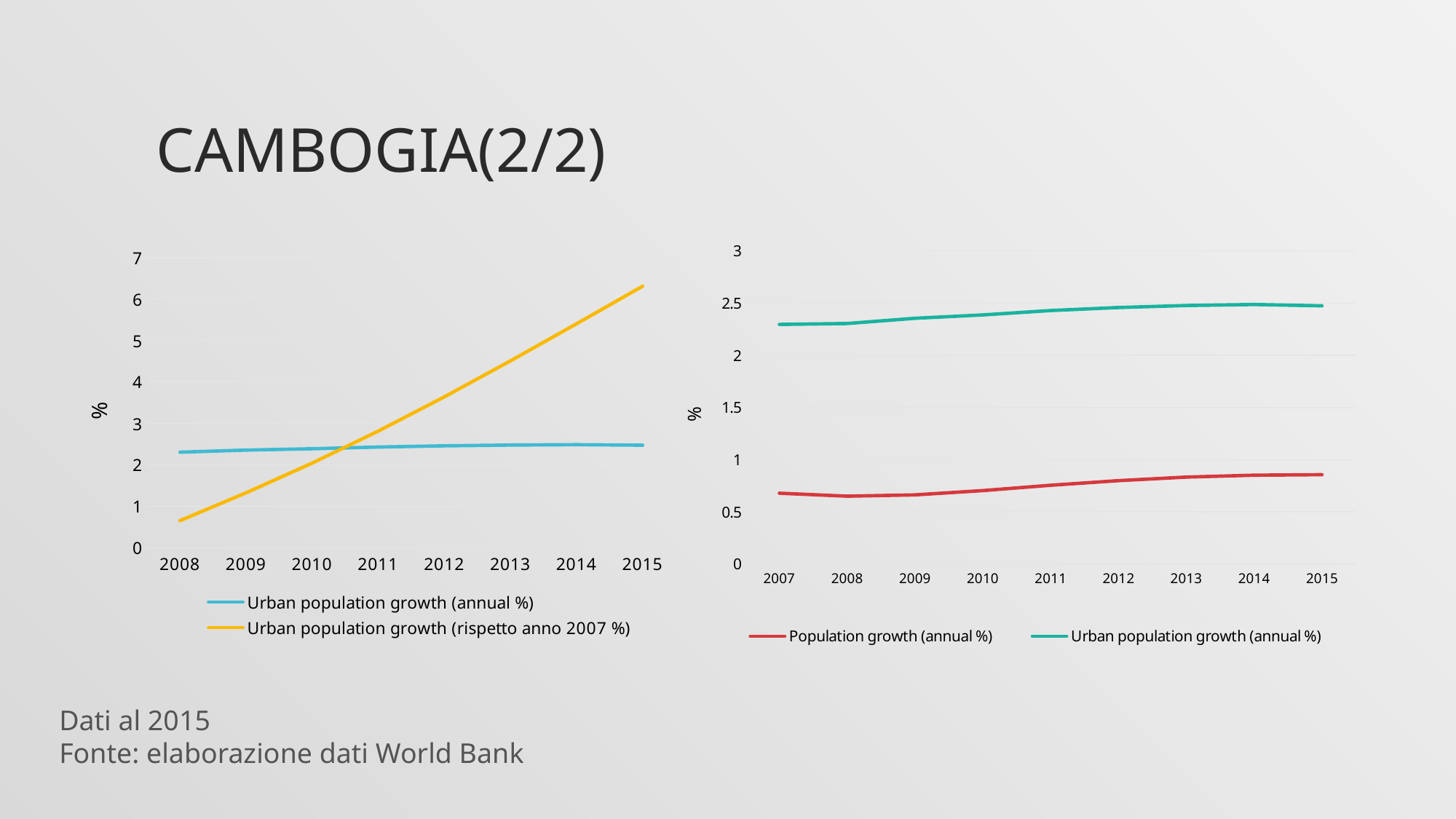
In the right chart, which series has the higher values throughout: 'Population growth (annual %)' or 'Urban population growth (annual %)'? Urban population growth (annual %) In the left chart, is the value for 'Urban population growth (rispetto anno 2007 %)' in 2015 greater or less than 5? greater What kind of chart is the left chart on the slide? Line chart In the left chart, is the value for 'Urban population growth (rispetto anno 2007 %)' in 2008 greater or less than 1? less How many years are shown on the x axis of the right chart? 9 In the right chart, is the value for 'Population growth (annual %)' in 2015 greater or less than 1? less In the left chart, which series has the higher value in 2008: 'Urban population growth (annual %)' or 'Urban population growth (rispetto anno 2007 %)'? Urban population growth (annual %) In the left chart, which series has the higher value in 2015: 'Urban population growth (annual %)' or 'Urban population growth (rispetto anno 2007 %)'? Urban population growth (rispetto anno 2007 %) How many series does the legend of the left chart list? 2 In the left chart, does the 'Urban population growth (rispetto anno 2007 %)' line rise or fall from 2008 to 2015? Rise What colour is the 'Population growth (annual %)' line in the right chart? Red How many years are shown on the x axis of the left chart? 8